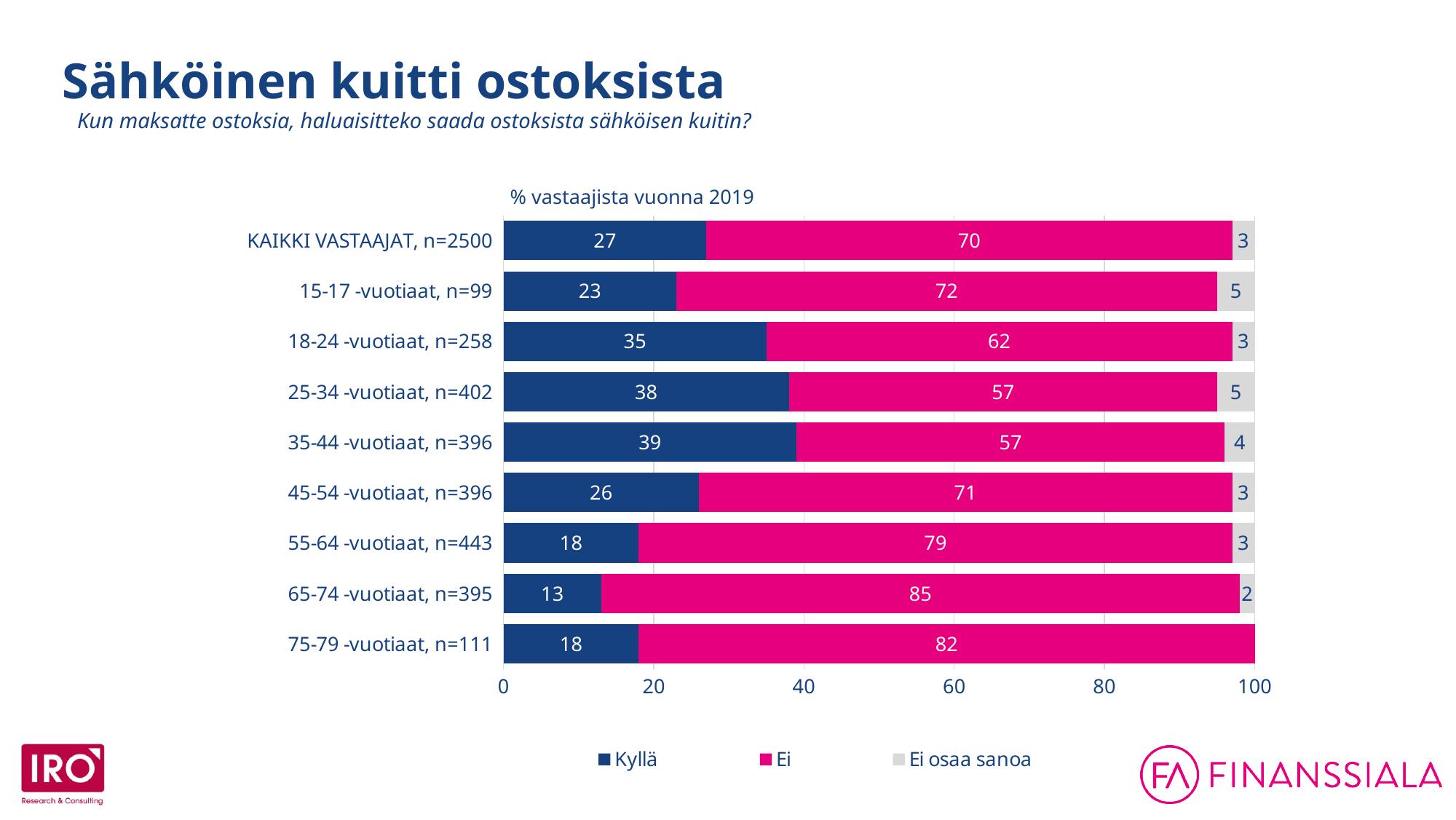
Which is larger: the Kyllä value for 18-24 -vuotiaat, n=258 or for 45-54 -vuotiaat, n=396? 18-24 -vuotiaat, n=258 What is the difference between the Ei values for 55-64 -vuotiaat, n=443 and KAIKKI VASTAAJAT, n=2500? 9 What is the Kyllä value for 25-34 -vuotiaat, n=402? 38 What is the total of the stacked bar for 35-44 -vuotiaat, n=396? 100 Which category has the lowest Kyllä value? 65-74 -vuotiaat, n=395 What is the Ei osaa sanoa value for 15-17 -vuotiaat, n=99? 5 Which category has the highest Kyllä value? 35-44 -vuotiaat, n=396 What is the Ei value for 65-74 -vuotiaat, n=395? 85 How many categories are shown on the chart? 9 How many series does the legend list? 3 What kind of chart is shown on the slide? Stacked bar chart Which category has the highest Ei value? 65-74 -vuotiaat, n=395